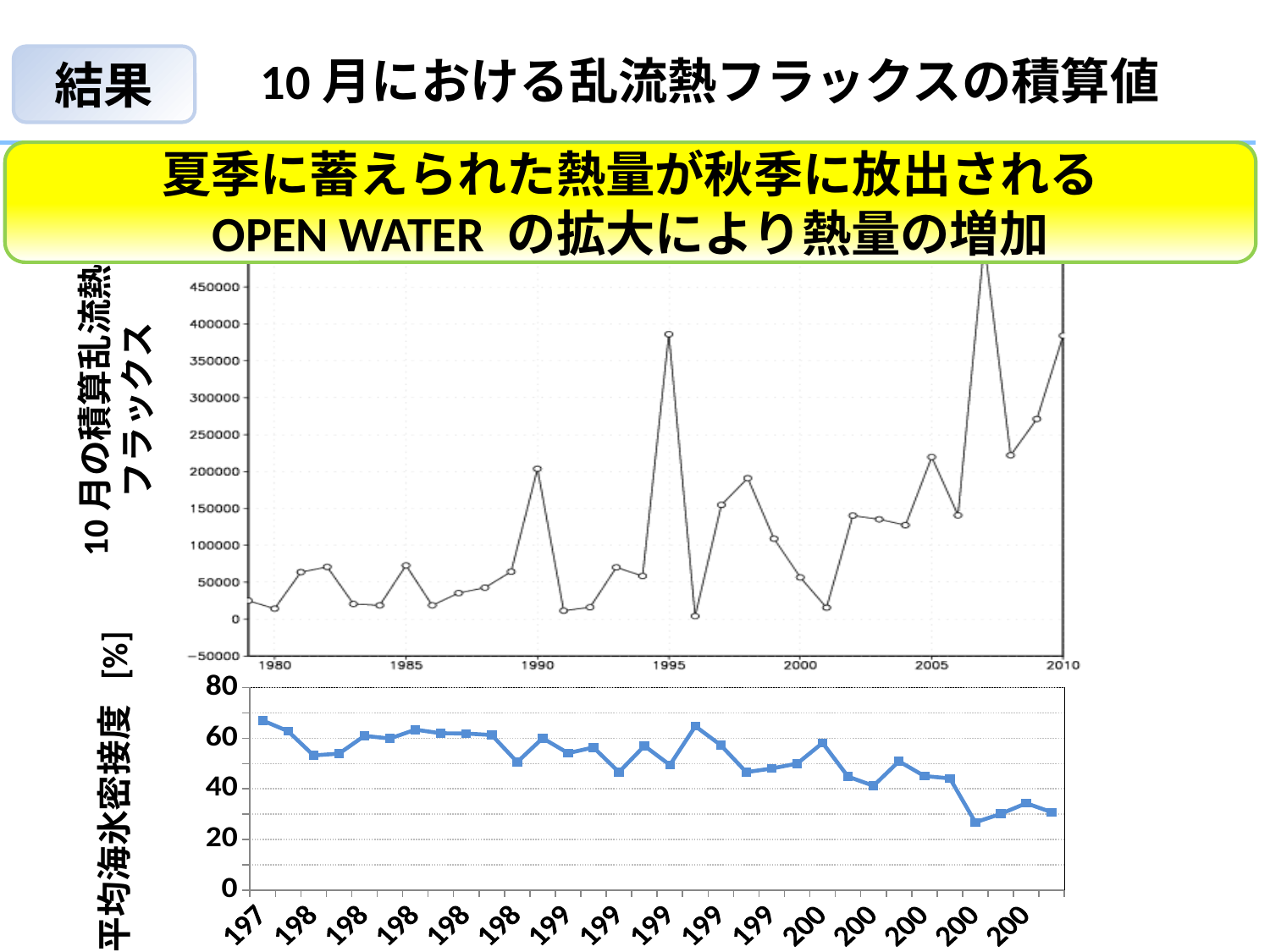
In the top chart (October accumulated turbulent heat flux), is the value for 1996 greater or less than 50000? less What is the y-axis label of the bottom chart? 平均海氷密接度 [%] In the top chart (October accumulated turbulent heat flux), which is larger, the value for 2007 or the value for 2010? 2007 In the bottom chart (mean sea ice concentration), is the first plotted value greater or less than 60? greater In the top chart (October accumulated turbulent heat flux), is the value for 2005 greater or less than 200000? greater In the top chart (October accumulated turbulent heat flux), which year has the highest value? 2007 In the top chart (October accumulated turbulent heat flux), which is larger, the value for 1990 or the value for 1995? 1995 What kind of chart is the bottom chart showing mean sea ice concentration? line chart In the bottom chart (mean sea ice concentration), do the values generally rise or fall from left to right along the x axis? fall What kind of chart is the top chart showing the October accumulated turbulent heat flux? line chart